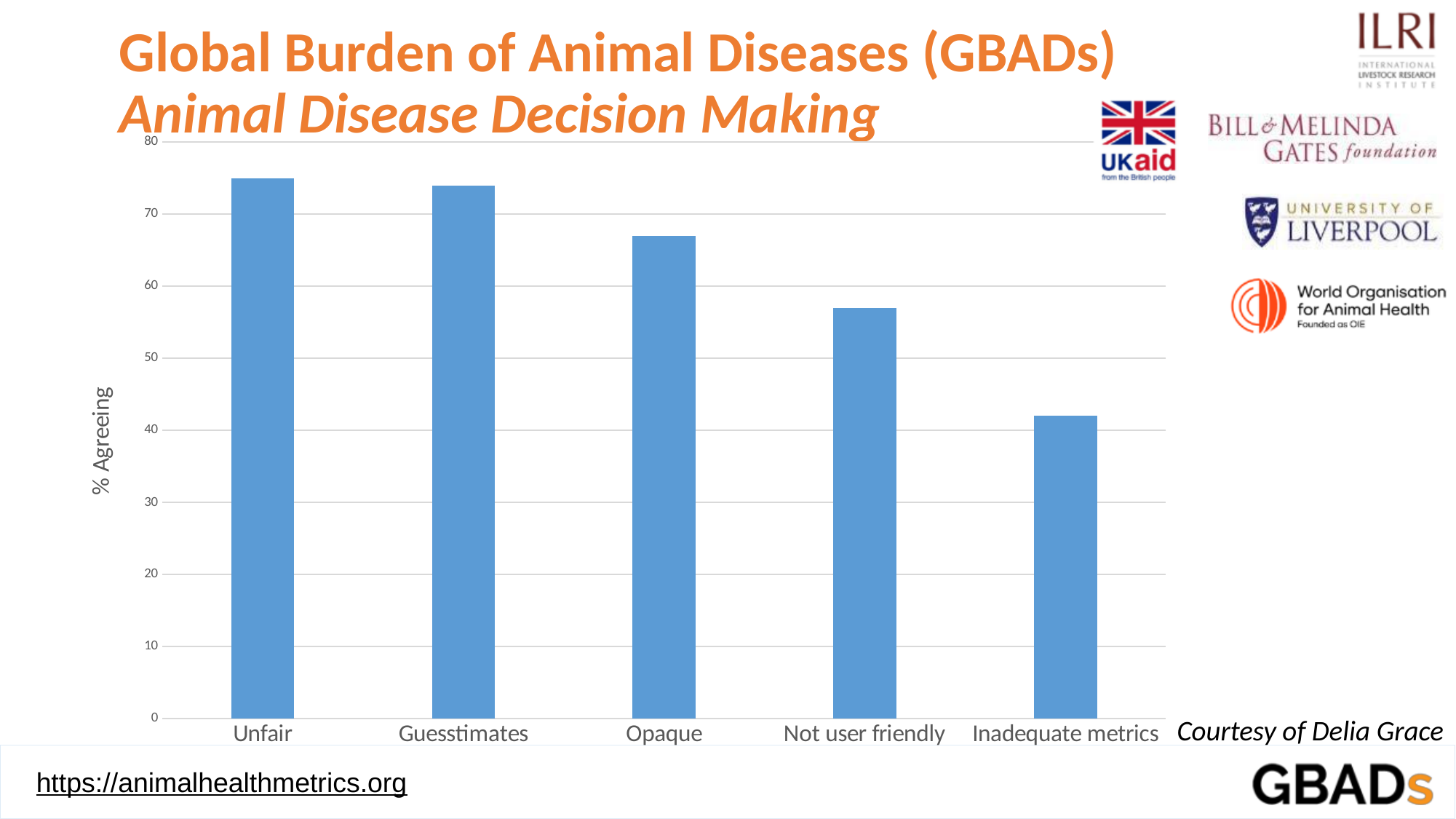
Is the value for Not user friendly greater or less than 60? less Is the value for Inadequate metrics greater or less than 50? less Is the value for Unfair greater or less than 70? greater What kind of chart is shown on the slide? bar chart Do the bar values rise or fall from left to right along the x axis? fall What is the label on the vertical axis of the chart? % Agreeing How many categories are plotted on the x axis of the chart? 5 Which category has the lowest % Agreeing? Inadequate metrics Which has a higher % Agreeing, Opaque or Not user friendly? Opaque Which has a higher % Agreeing, Inadequate metrics or Guesstimates? Guesstimates